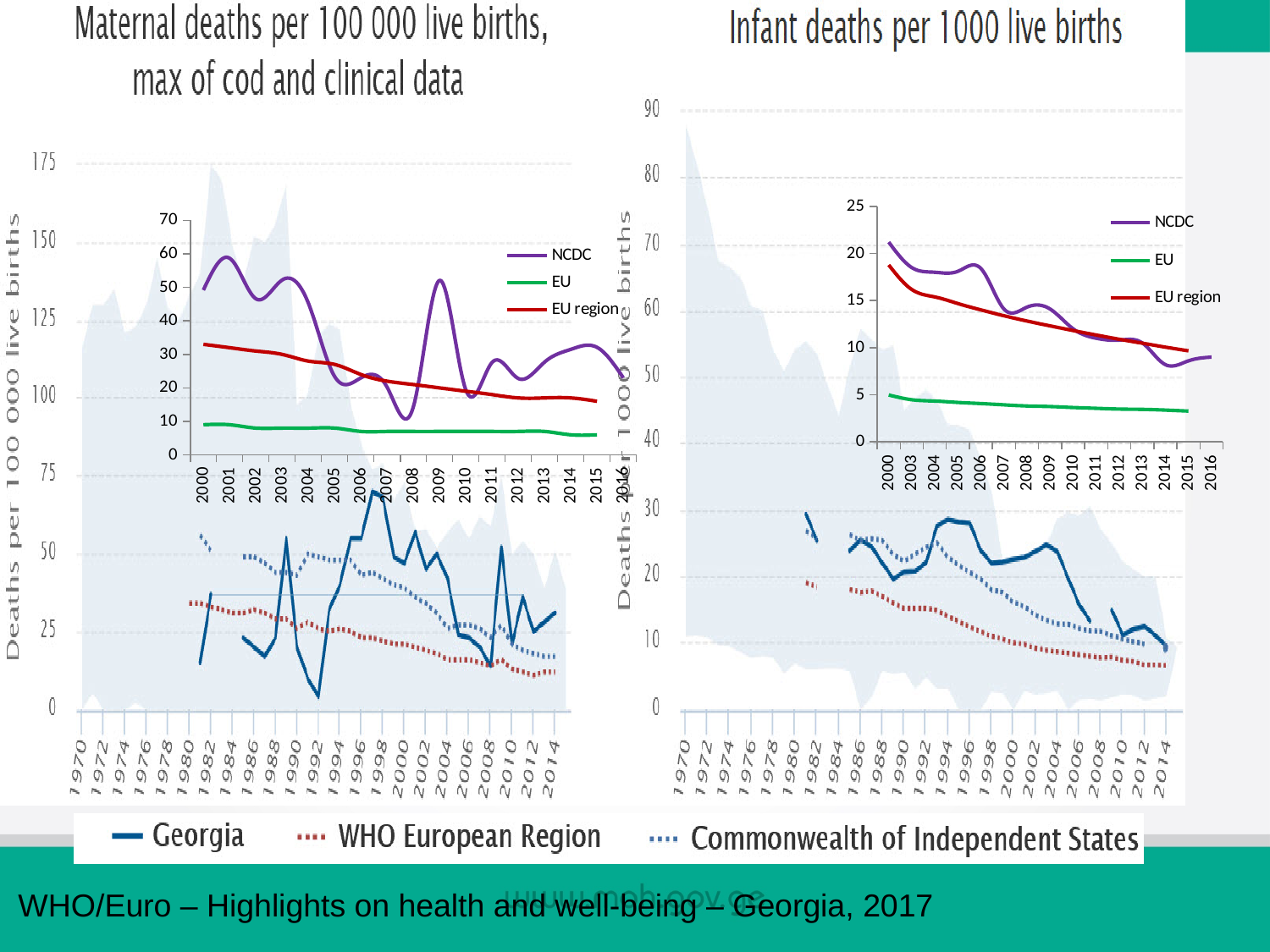
In the inset chart on the 'Maternal deaths per 100 000 live births' chart, does the EU region line rise or fall from 2000 to 2015? fall In the inset chart on the 'Infant deaths per 1000 live births' chart, does the EU region line rise or fall from 2000 to 2015? fall In the inset chart on the 'Infant deaths per 1000 live births' chart, is the EU region value in 2000 greater or less than 15? greater In the inset chart on the 'Infant deaths per 1000 live births' chart, which series is higher in 2000, NCDC or EU? NCDC In the inset chart on the 'Maternal deaths per 100 000 live births' chart, which series is higher in 2015, EU or EU region? EU region In the inset chart on the 'Maternal deaths per 100 000 live births' chart, is the NCDC value in 2001 greater or less than 50? greater How many series does the legend of the inset chart on the 'Infant deaths per 1000 live births' chart list? 3 Which three series does the legend at the bottom of the slide list? Georgia, WHO European Region, Commonwealth of Independent States In the inset chart on the 'Infant deaths per 1000 live births' chart, is the EU value in 2000 greater or less than 10? less What kind of chart is the 'Infant deaths per 1000 live births' chart? line chart In the inset chart on the 'Infant deaths per 1000 live births' chart, which series has the lowest values across the whole period? EU